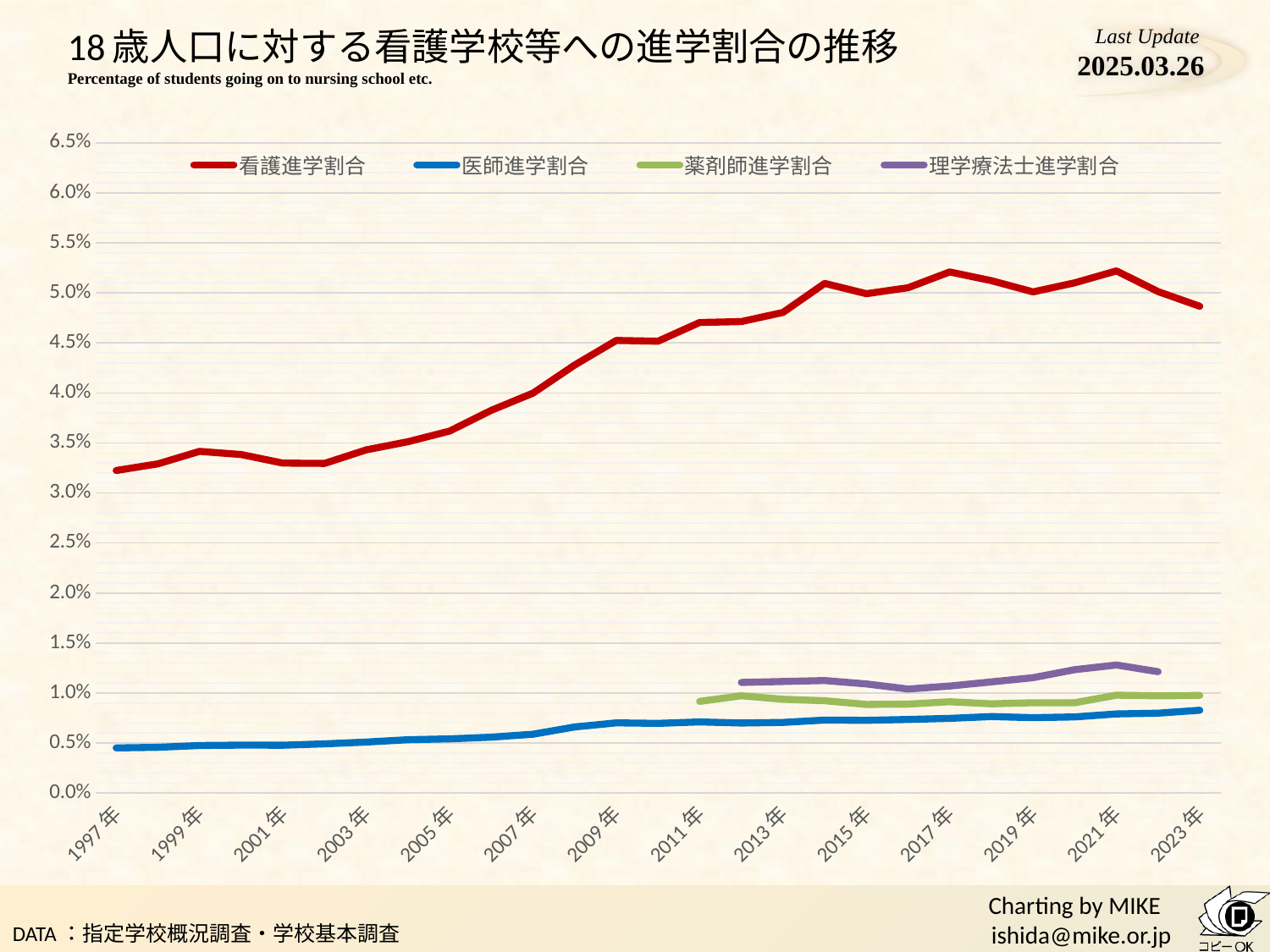
Does 看護進学割合 generally rise or fall from 1997年 to 2017年? rise How many series does the legend list? 4 In 2023年, which is higher, 医師進学割合 or 薬剤師進学割合? 薬剤師進学割合 Is the value for 理学療法士進学割合 in 2021年 greater or less than 1.0%? greater Is the value for 看護進学割合 in 2023年 greater or less than 4.5%? greater Is the value for 看護進学割合 in 2009年 greater or less than 4.0%? greater What kind of chart is shown on the slide? line chart What colour is the 看護進学割合 line? red What is the title of the chart? 18歳人口に対する看護学校等への進学割合の推移 Which series has the highest values throughout the chart? 看護進学割合